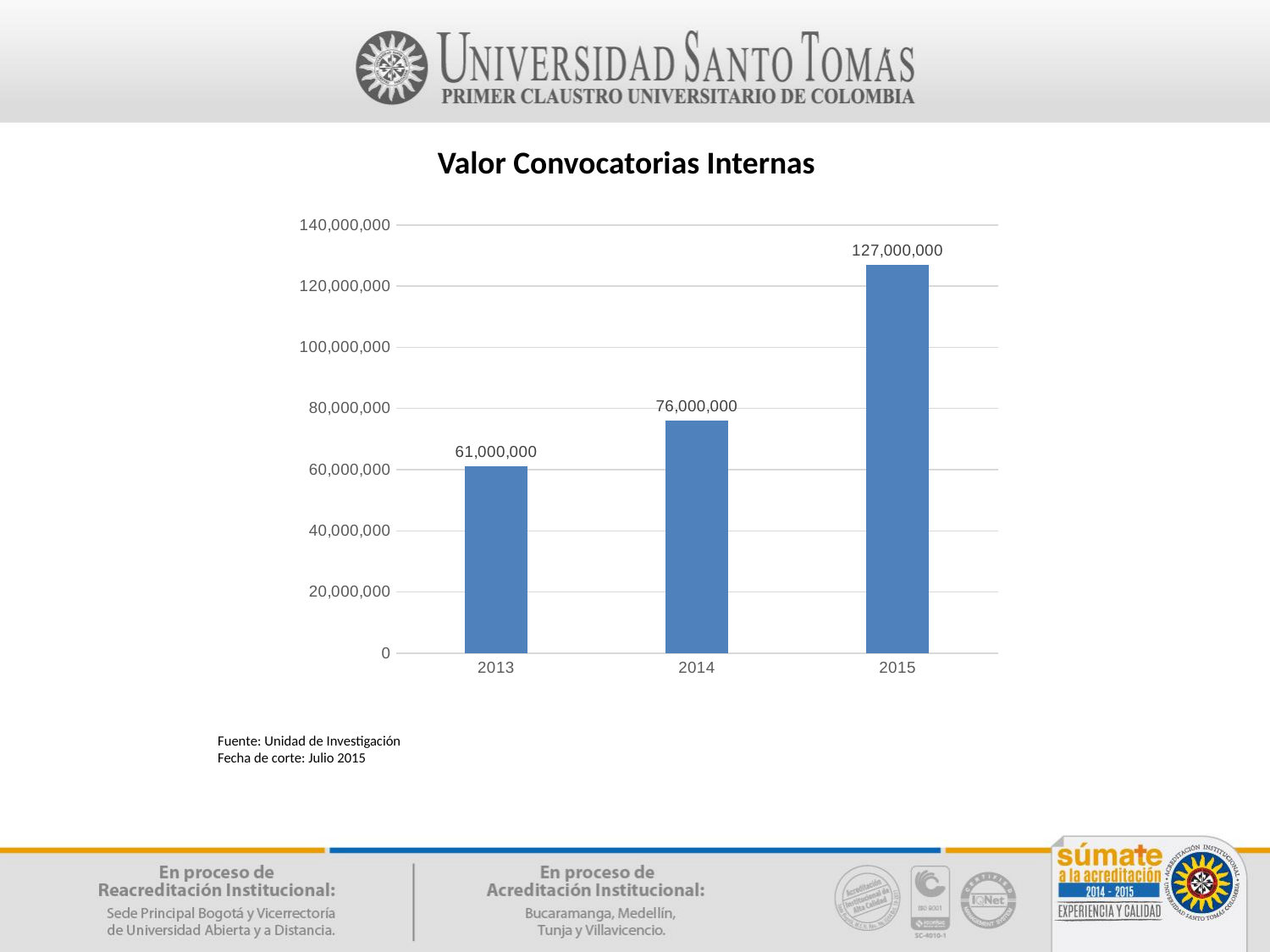
What is the difference between the values for 2014 and 2013? 15,000,000 What is the value for 2015? 127,000,000 What is the difference between the values for 2015 and 2014? 51,000,000 Which is larger, the value for 2013 or the value for 2014? 2014 What is the value for 2014? 76,000,000 Do the values rise or fall from 2013 to 2015? rise How many years are shown on the x axis? 3 Which year has the highest value? 2015 Which year has the lowest value? 2013 Is the value for 2015 greater or less than 120,000,000? greater What is the value for 2013? 61,000,000 What kind of chart is shown on the slide? bar chart